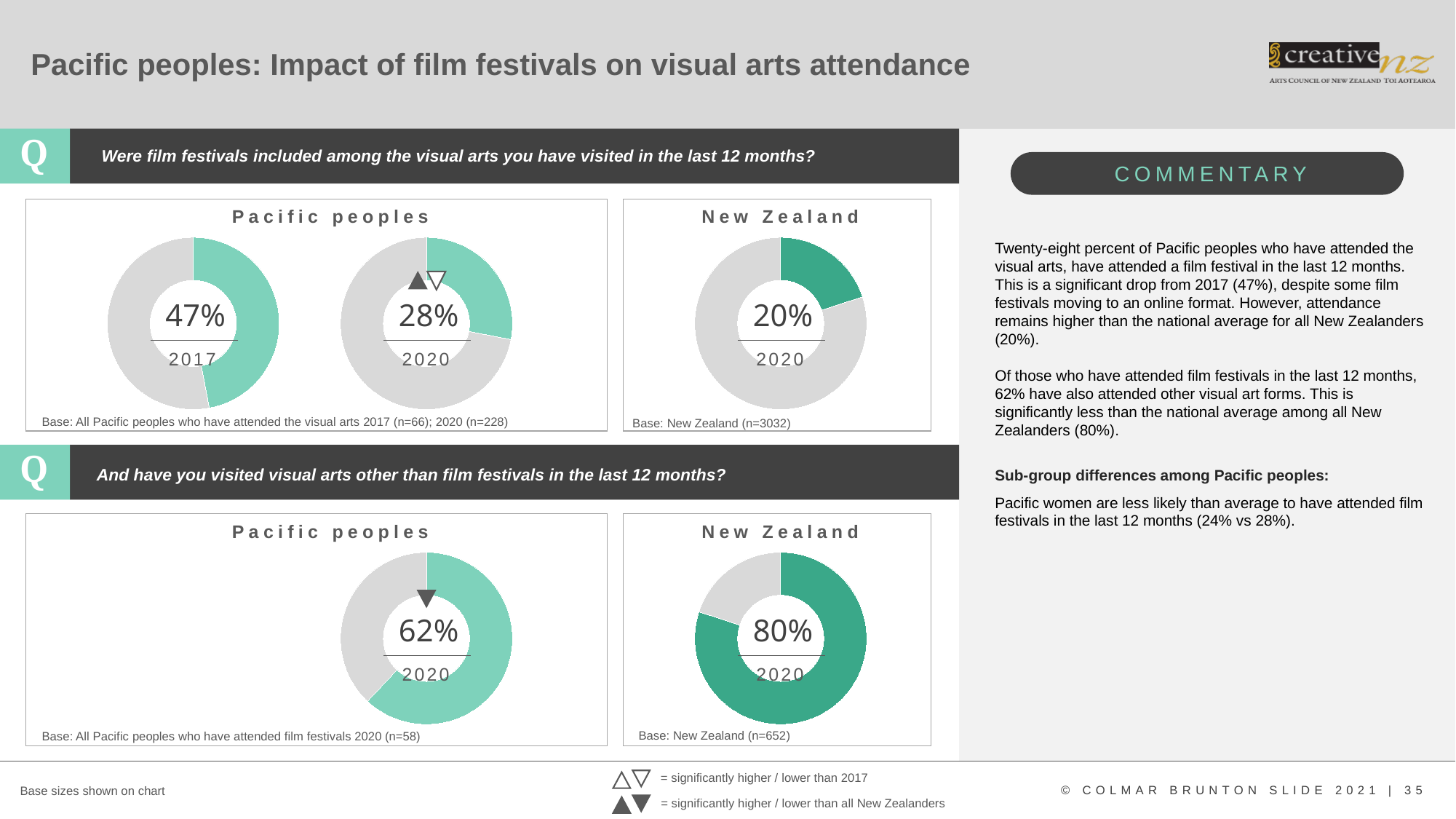
How many donut charts are shown on the slide in total? 5 In the bottom row of charts, what is the difference between the New Zealand 2020 value and the Pacific peoples 2020 value? 18 percentage points In the top row of charts, which is larger: the Pacific peoples 2020 value or the New Zealand 2020 value? Pacific peoples 2020 In the top 'Pacific peoples' chart (film festivals included among visual arts visited), what percentage is shown for 2020? 28% In the top 'New Zealand' chart (film festivals included among visual arts visited), what percentage is shown for 2020? 20% What type of chart is used to display the percentages on this slide? Donut (pie) chart In the bottom 'Pacific peoples' chart (visited visual arts other than film festivals), what percentage is shown for 2020? 62% In the top 'Pacific peoples' chart, by how many percentage points did the value fall from 2017 to 2020? 19 percentage points In the top 'Pacific peoples' chart (film festivals included among visual arts visited), what percentage is shown for 2017? 47% In the bottom 'New Zealand' chart (visited visual arts other than film festivals), what percentage is shown for 2020? 80% In the top 'Pacific peoples' chart, does the value rise or fall from 2017 to 2020? fall In the bottom row of charts, which is larger: the Pacific peoples 2020 value or the New Zealand 2020 value? New Zealand 2020